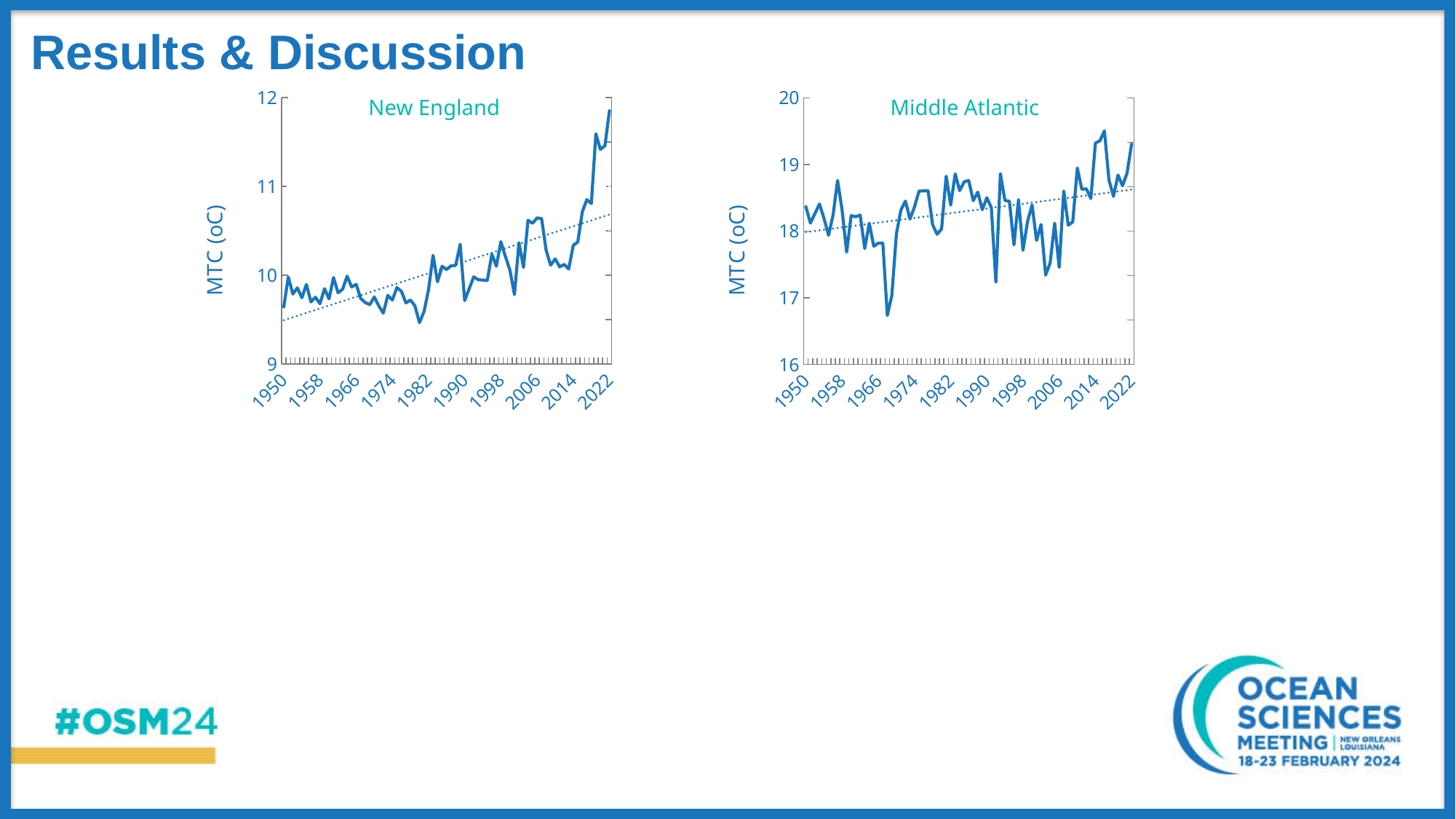
What kind of chart is the New England chart? line chart In the New England chart, do the MTC values generally rise or fall from 1950 to 2022? rise In the Middle Atlantic chart, does the dotted trend line rise or fall from 1950 to 2022? rise In the New England chart, is the MTC value at 1950 greater or less than 10? less What kind of chart is the Middle Atlantic chart? line chart In the Middle Atlantic chart, is the MTC value at 2022 greater or less than 19? greater In the Middle Atlantic chart, is the MTC value at 1950 greater or less than 18? greater What is the highest value shown on the y-axis of the Middle Atlantic chart? 20 What is the y-axis label on the New England chart? MTC (oC) How many charts are shown on the slide? 2